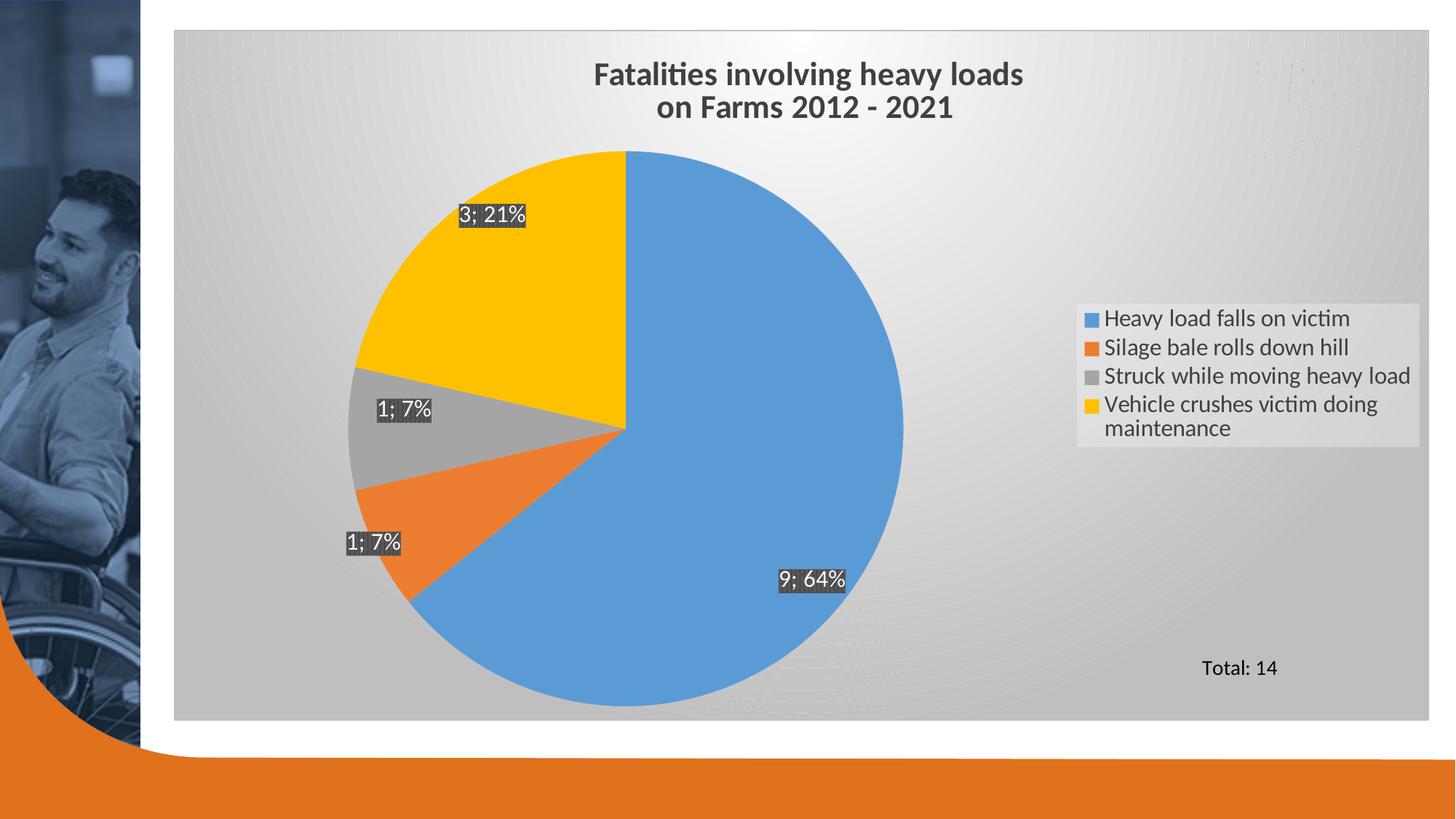
What kind of chart is shown on the slide? pie chart Which category has the largest slice? Heavy load falls on victim What is the title of the chart? Fatalities involving heavy loads on Farms 2012 - 2021 What is the total number of fatalities shown on the slide? 14 How many fatalities are attributed to 'Heavy load falls on victim'? 9 How many categories does the legend list? 4 What share of the pie does 'Silage bale rolls down hill' represent? 7% What share of the pie does 'Heavy load falls on victim' represent? 64% What is the difference in fatalities between 'Heavy load falls on victim' and 'Vehicle crushes victim doing maintenance'? 6 Which is larger, the slice for 'Vehicle crushes victim doing maintenance' or the slice for 'Struck while moving heavy load'? Vehicle crushes victim doing maintenance What share of the pie does 'Vehicle crushes victim doing maintenance' represent? 21% How many fatalities are attributed to 'Vehicle crushes victim doing maintenance'? 3